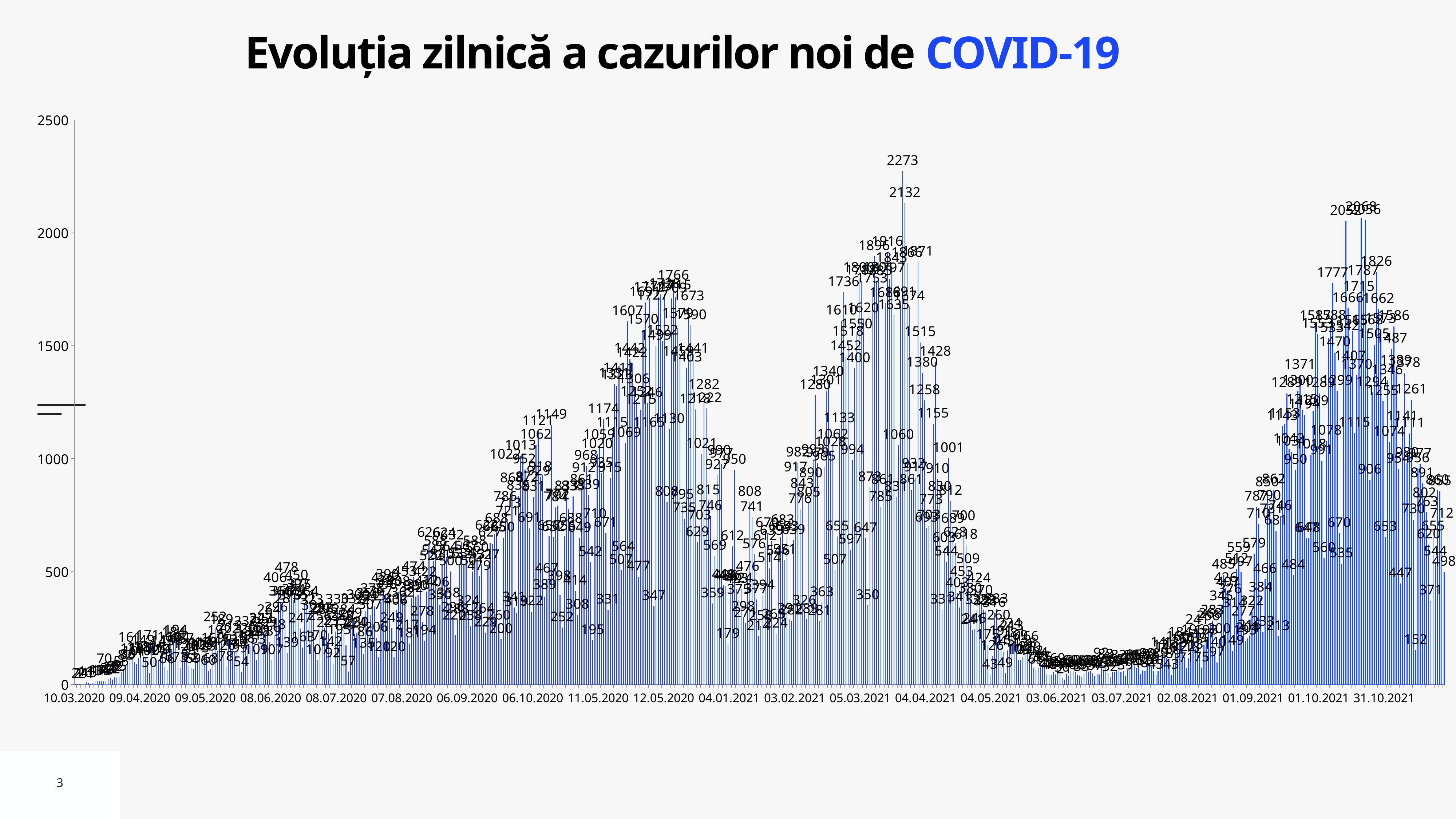
What is the second-highest daily value labelled on the chart, just below the 2273 peak? 2132 Is the value for 10.03.2020 greater or less than 500? less Which is higher, the peak around 04.04.2021 or the peak around 12.05.2020? the peak around 04.04.2021 What is the title of the chart on the slide? Evoluția zilnică a cazurilor noi de COVID-19 Is the value for 03.06.2021 greater or less than 500? less Do the values rise or fall between 04.04.2021 and 03.06.2021? fall Do the values rise or fall between 03.07.2021 and 01.10.2021? rise Is the highest value on the chart greater or less than 2000? greater What is the highest daily value labelled on the chart? 2273 What kind of chart is shown on the slide? bar chart What is the highest tick value shown on the vertical axis? 2500